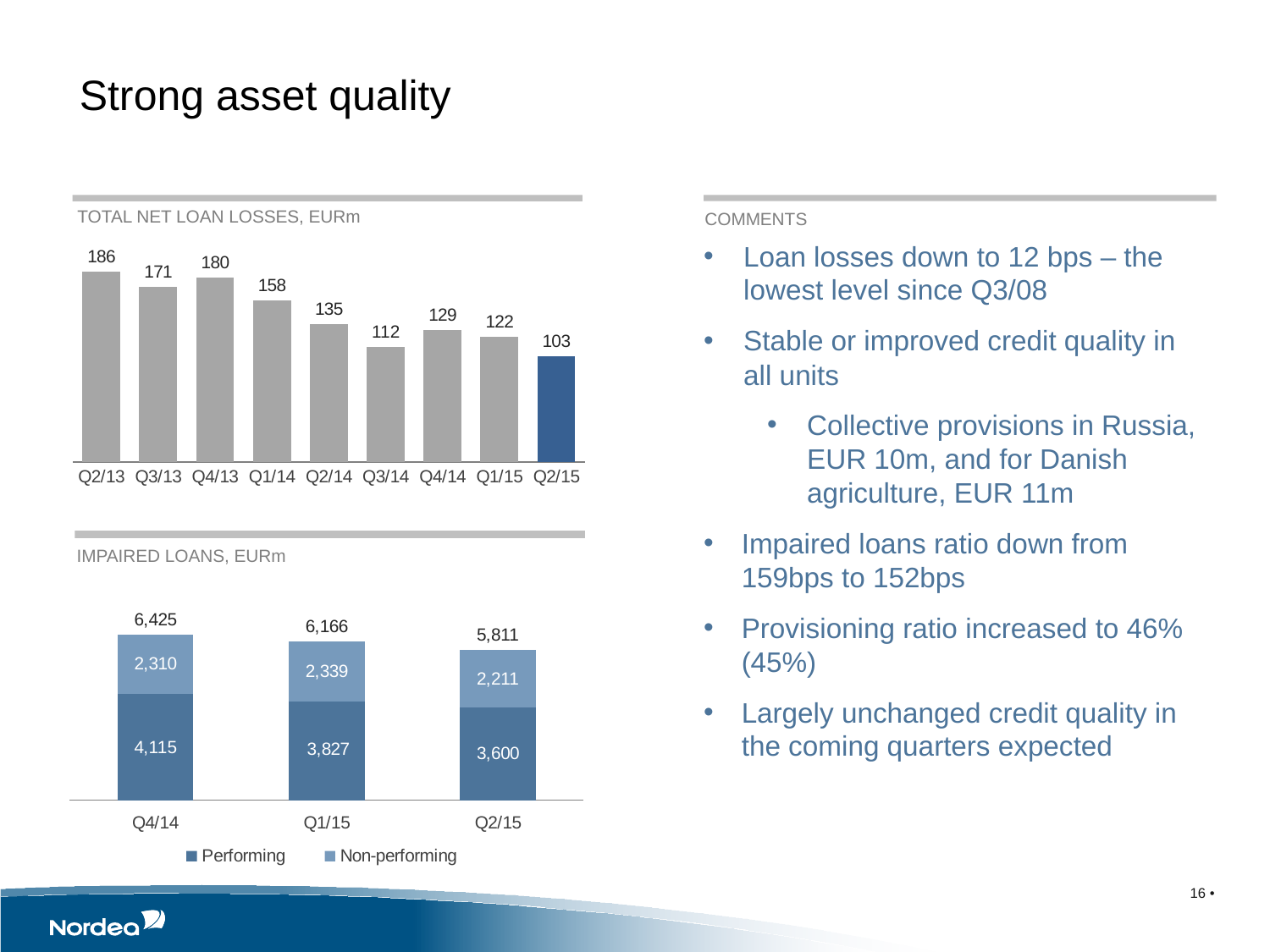
How many series does the legend of the 'Impaired loans, EURm' chart list? 2 In the 'Impaired loans, EURm' chart, what is the total of the stacked bar for Q2/15? 5,811 In the 'Impaired loans, EURm' chart, what is the Performing value for Q1/15? 3,827 How many quarters are shown in the 'Total net loan losses, EURm' chart? 9 In the 'Total net loan losses, EURm' chart, what is the difference between Q2/13 and Q2/15? 83 In the 'Total net loan losses, EURm' chart, what is the value for Q2/15? 103 In the 'Total net loan losses, EURm' chart, which quarter has the highest value? Q2/13 What kind of chart is the 'Impaired loans, EURm' chart? stacked bar chart In the 'Total net loan losses, EURm' chart, which is larger, Q3/14 or Q4/14? Q4/14 In the 'Impaired loans, EURm' chart, what is the difference between the Non-performing values for Q1/15 and Q2/15? 128 In the 'Total net loan losses, EURm' chart, do the values generally rise or fall from Q2/13 to Q2/15? fall In the 'Total net loan losses, EURm' chart, which quarter has the lowest value? Q2/15